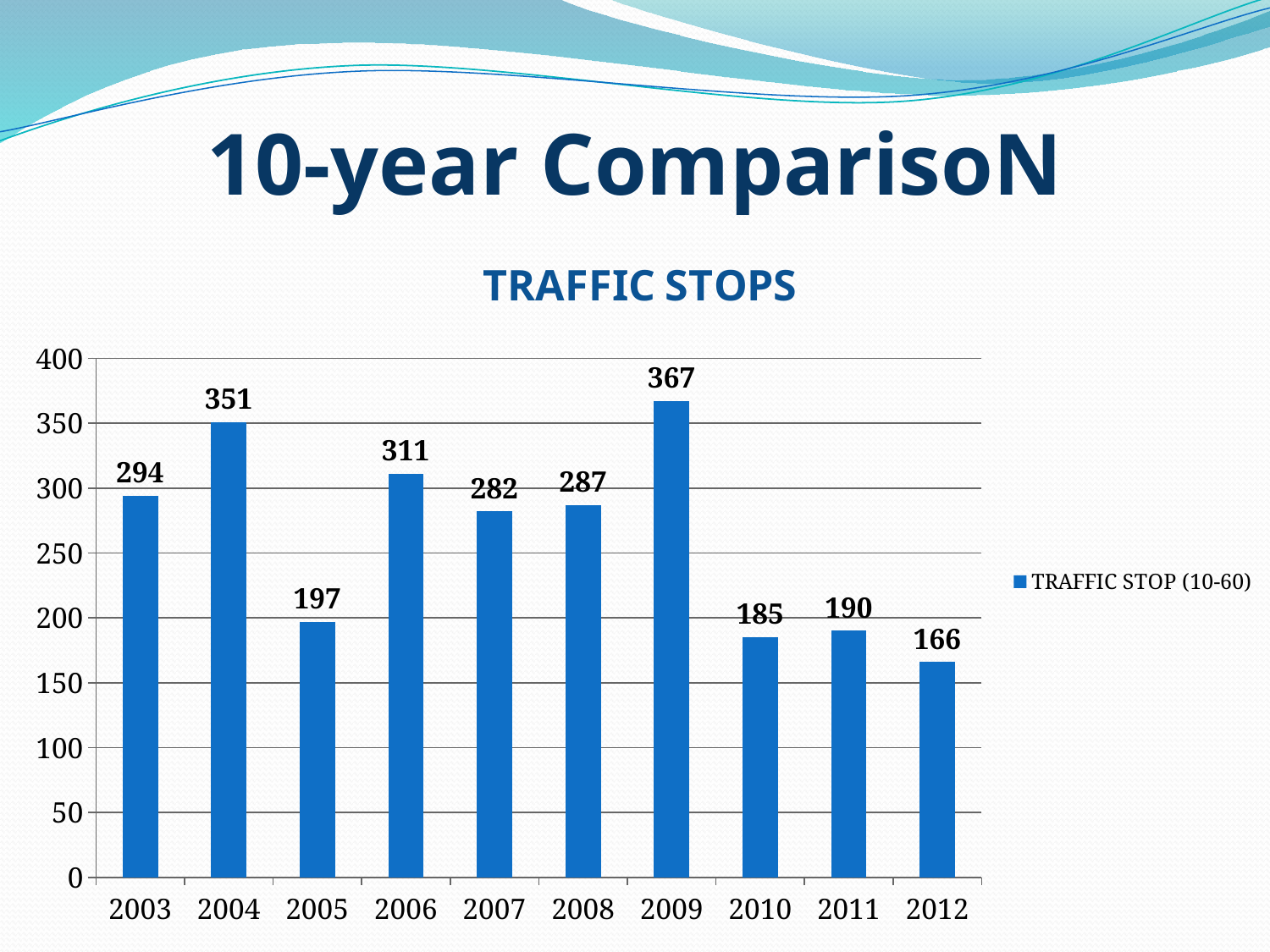
How many series does the legend list? 1 What is the value for 2009? 367 Is the value for 2006 greater or less than 300? greater Which is larger, the value for 2007 or the value for 2008? 2008 Which year has the highest number of traffic stops? 2009 What is the value for 2012? 166 What is the legend entry for the series? TRAFFIC STOP (10-60) What is the value for 2003? 294 How many years are shown on the x axis? 10 Which year has the lowest number of traffic stops? 2012 What is the difference between the values for 2004 and 2005? 154 What kind of chart is shown? bar chart